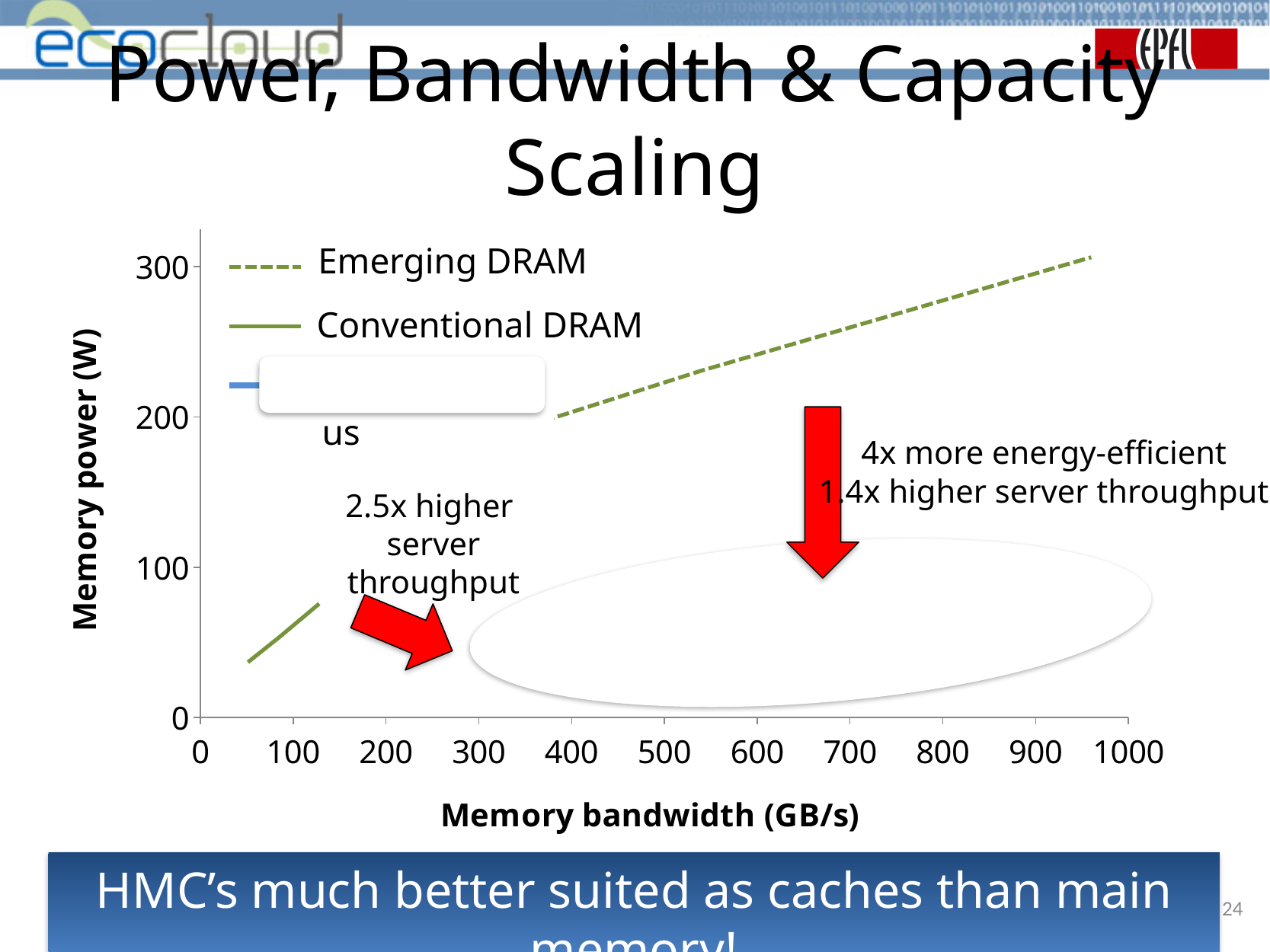
Is the memory power of the Conventional DRAM series at its highest bandwidth point greater or less than 100 W? less Which series reaches a higher memory bandwidth, Emerging DRAM or Conventional DRAM? Emerging DRAM Is the memory power of the Conventional DRAM series at its lowest bandwidth point greater or less than 100 W? less What is the highest value shown on the x axis of the chart? 1000 What is the title of the x axis of the chart? Memory bandwidth (GB/s) Which series reaches a higher memory power, Emerging DRAM or Conventional DRAM? Emerging DRAM Is the memory power of the Emerging DRAM series at its highest bandwidth point greater or less than 250 W? greater What kind of chart is shown on the slide? line chart Does the memory power of the Emerging DRAM series rise or fall as memory bandwidth increases? rise What is the title of the y axis of the chart? Memory power (W) Does the memory power of the Conventional DRAM series rise or fall as memory bandwidth increases? rise